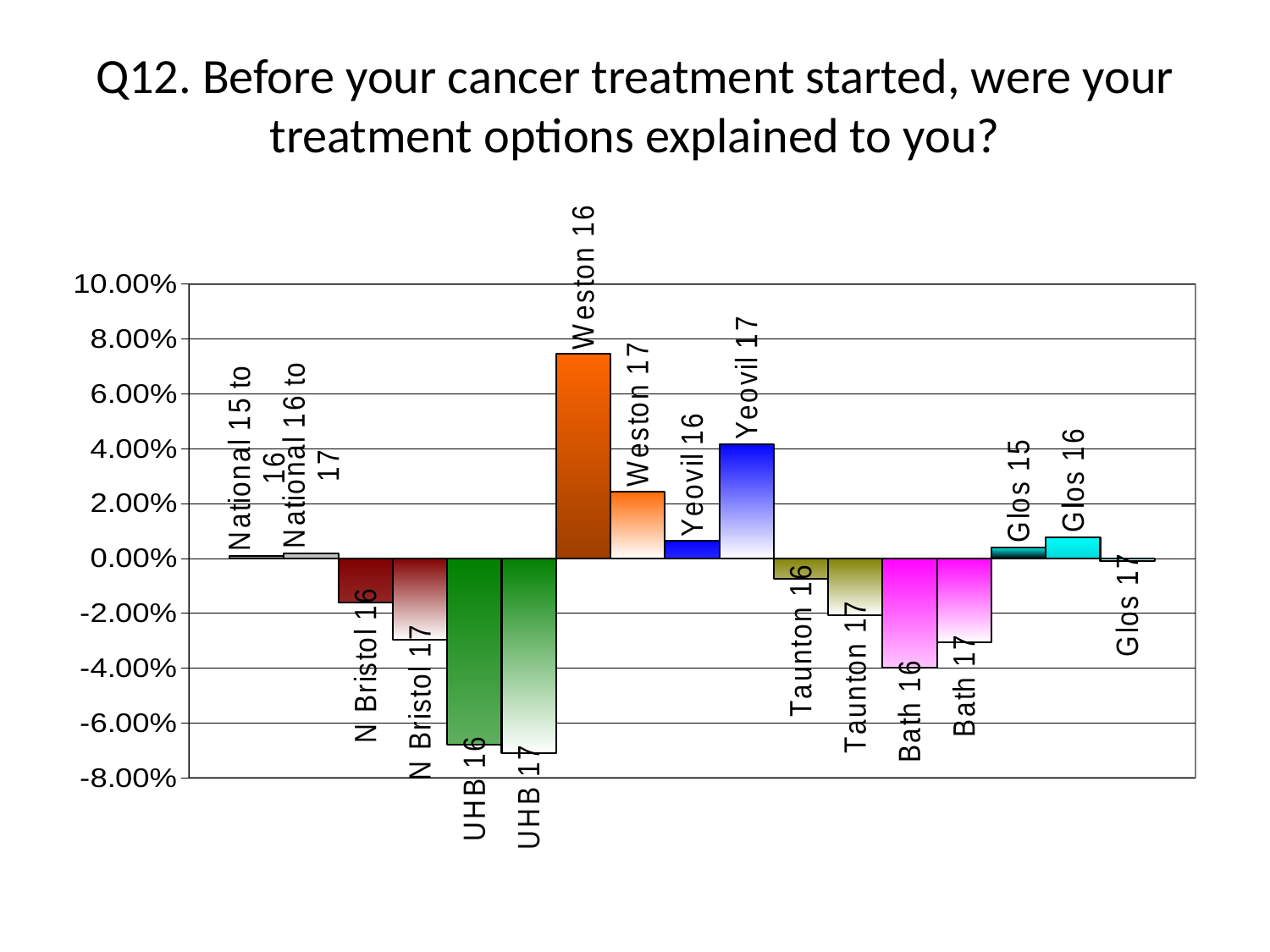
Which category has the highest value in the chart? Weston 16 What is the title of the chart on the slide? Q12. Before your cancer treatment started, were your treatment options explained to you? What kind of chart is shown on the slide? bar chart Which is larger, the value for Weston 17 or the value for Yeovil 17? Yeovil 17 Is the value for UHB 16 greater or less than -6.00%? less Is the value for Weston 16 greater or less than 6.00%? greater Is the value for Yeovil 17 greater or less than 2.00%? greater Which category has the lowest value in the chart? UHB 17 Which is larger, the value for Weston 16 or the value for Yeovil 17? Weston 16 How many categories (bars) are plotted in the chart? 17